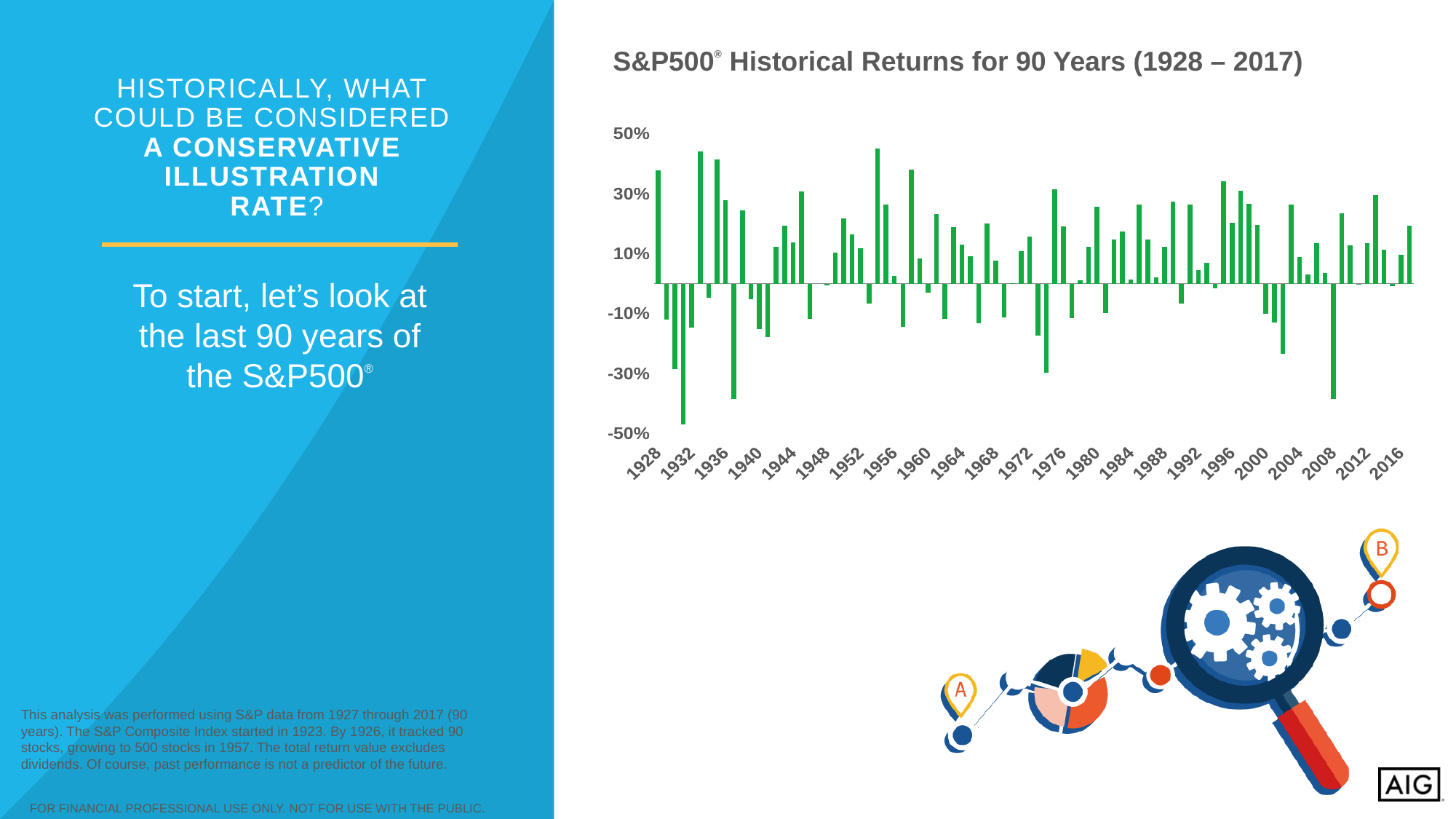
What type of chart is shown on the slide? Bar chart Which year has the larger return, 1980 or 1932? 1980 Is the value for 2008 greater or less than -30%? less What colour are the bars in the chart? Green What is the title of the chart? S&P500 Historical Returns for 90 Years (1928 – 2017) Is the value for 1936 greater or less than 10%? greater Is the value for 1980 greater or less than 10%? greater Which year has the larger return, 1928 or 2008? 1928 How many years of returns does the chart cover? 90